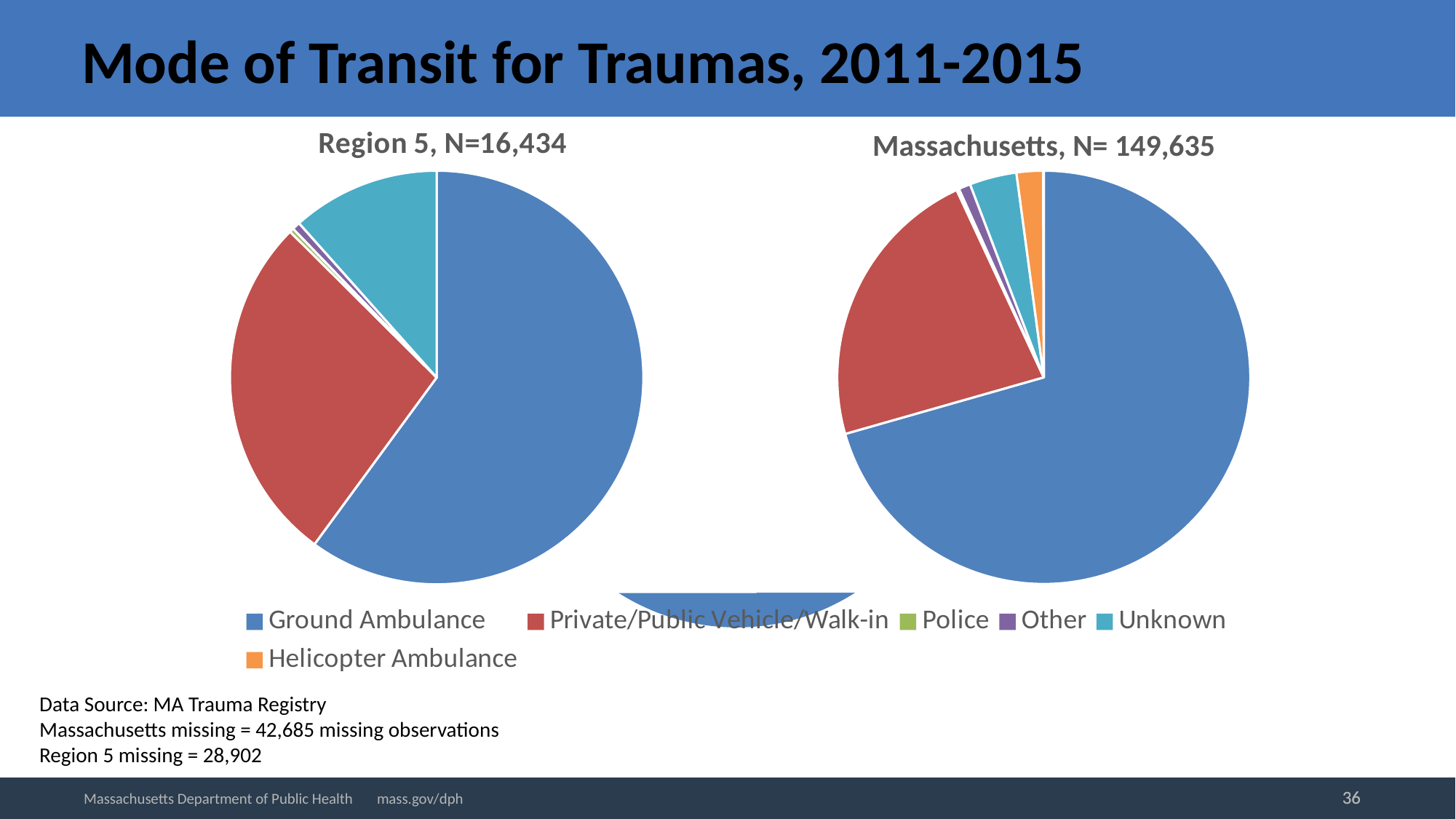
What is the N value shown in the title of the Region 5 pie chart? 16,434 Comparing the two pie charts, which has the larger share for Unknown: Region 5 or Massachusetts? Region 5 What kind of chart is used for the Region 5 data on this slide? Pie chart What is the N value shown in the title of the Massachusetts pie chart? 149,635 In the Region 5 pie chart, which mode of transit has the largest slice? Ground Ambulance What is the title of the slide containing the two pie charts? Mode of Transit for Traumas, 2011-2015 Comparing the two pie charts, which has the larger share for Ground Ambulance: Region 5 or Massachusetts? Massachusetts In the Massachusetts pie chart, which mode of transit has the largest slice? Ground Ambulance How many categories does the shared legend list for the pie charts? 6 Which colour represents Helicopter Ambulance in the legend? Orange In the Massachusetts pie chart, which is larger: the Private/Public Vehicle/Walk-in slice or the Helicopter Ambulance slice? Private/Public Vehicle/Walk-in